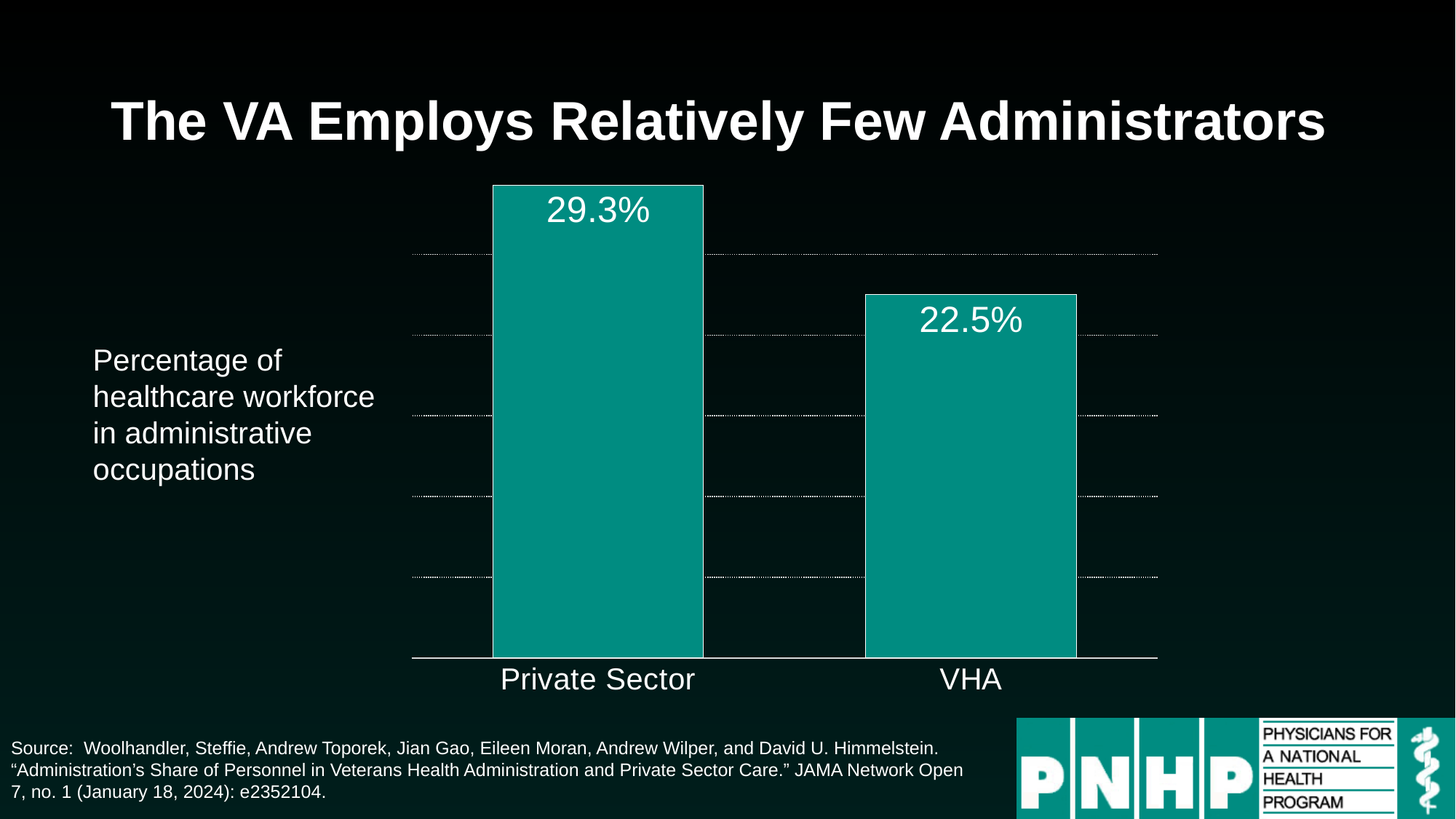
Do the values rise or fall from Private Sector to VHA? Fall What is the difference between the Private Sector and VHA values? 6.8% Which category has the highest value? Private Sector How many categories are shown on the chart? 2 What kind of chart is shown on the slide? Bar chart What colour are the bars in the chart? Teal What is the title of the slide containing the chart? The VA Employs Relatively Few Administrators What is the value for Private Sector? 29.3% Which category has the lowest value? VHA Which is larger, the value for Private Sector or the value for VHA? Private Sector What is the value for VHA? 22.5%